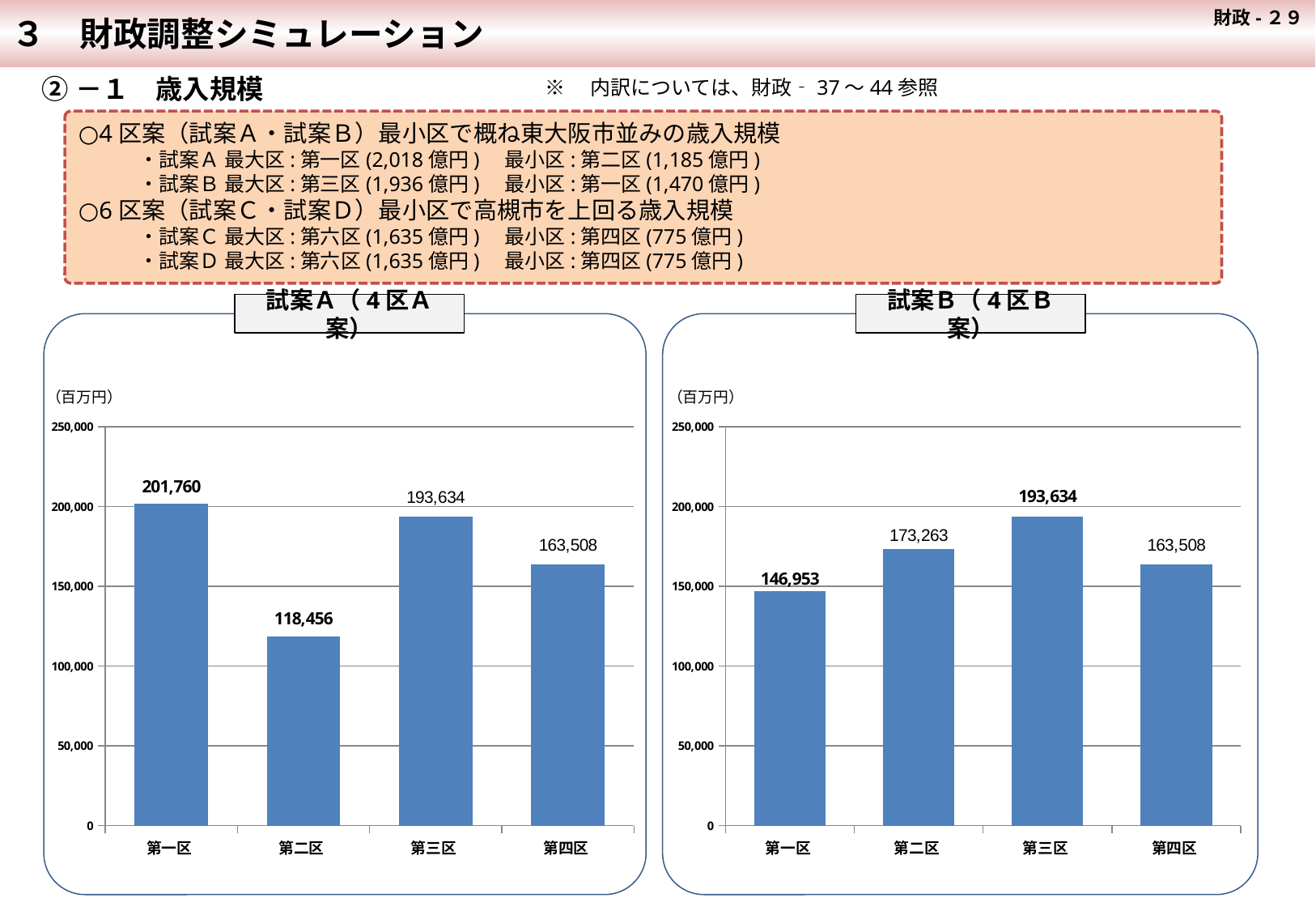
What type of chart is the 試案A (4区A案) chart? bar chart In the 試案B (4区B案) chart, which is larger, the value for 第二区 or the value for 第四区? 第二区 In the 試案B (4区B案) chart, what is the value for 第一区? 146,953 In the 試案B (4区B案) chart, what is the value for 第二区? 173,263 In the 試案A (4区A案) chart, what is the value for 第二区? 118,456 In the 試案A (4区A案) chart, what is the difference between the values for 第一区 and 第二区? 83,304 In the 試案A (4区A案) chart, which district has the lowest value? 第二区 How many districts are shown in the 試案B (4区B案) chart? 4 In the 試案B (4区B案) chart, which district has the lowest value? 第一区 In the 試案B (4区B案) chart, which district has the highest value? 第三区 In the 試案A (4区A案) chart, what is the value for 第一区? 201,760 In the 試案A (4区A案) chart, which district has the highest value? 第一区